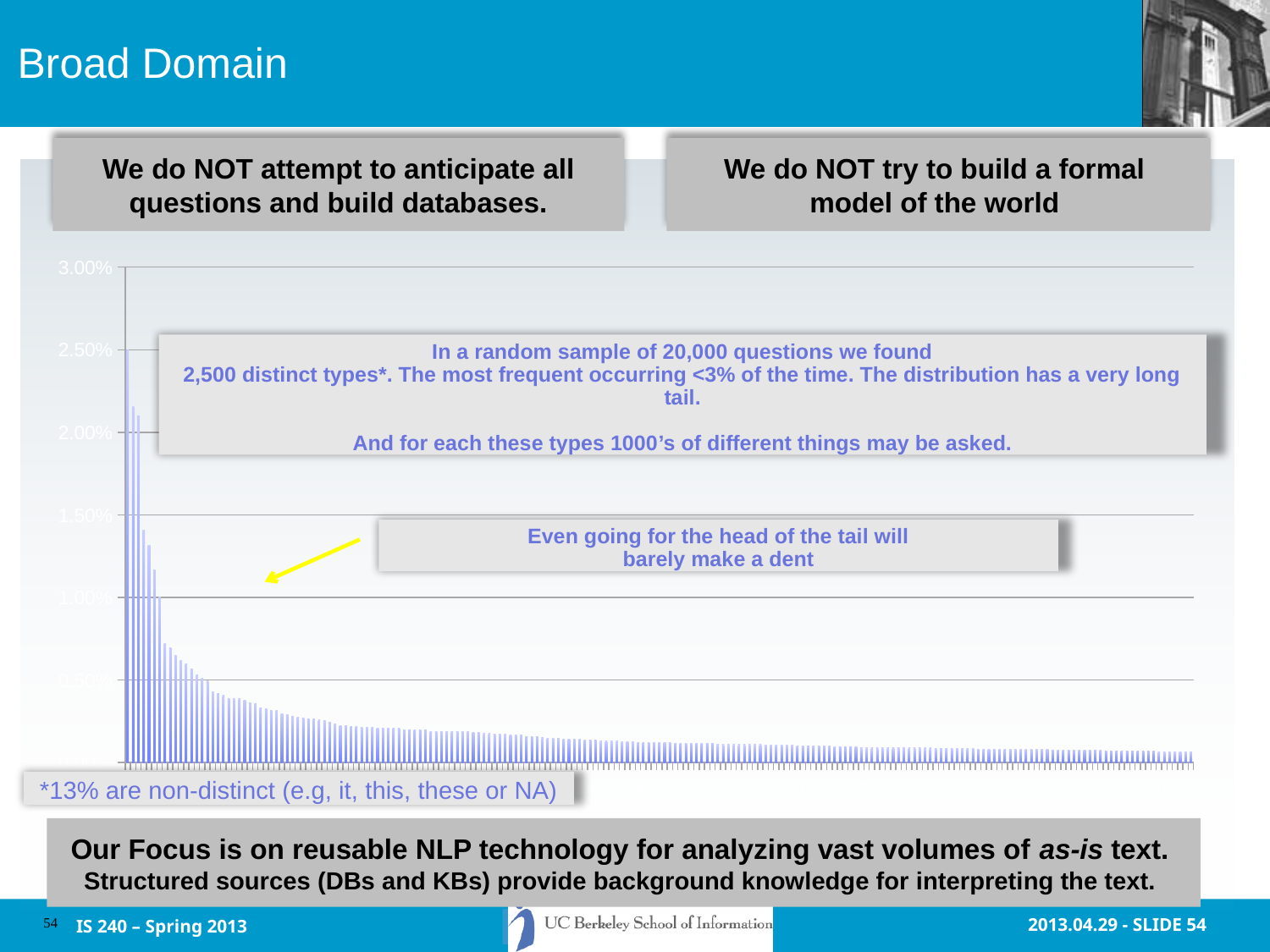
Is the value of the leftmost (tallest) bar greater or less than 3.00%? less Which bar in the chart is the highest? the leftmost bar What is the highest value labelled on the chart's y axis? 3.00% Is the value of the leftmost (tallest) bar greater or less than 2.00%? greater What is the interval between consecutive tick labels on the chart's y axis? 0.50% Are the values of the bars at the far right end of the chart greater or less than 0.50%? less Do the bar values rise or fall moving from left to right along the x axis? fall What kind of chart is shown on the slide? bar chart Is the leftmost bar larger or smaller than the bars in the right half of the chart? larger